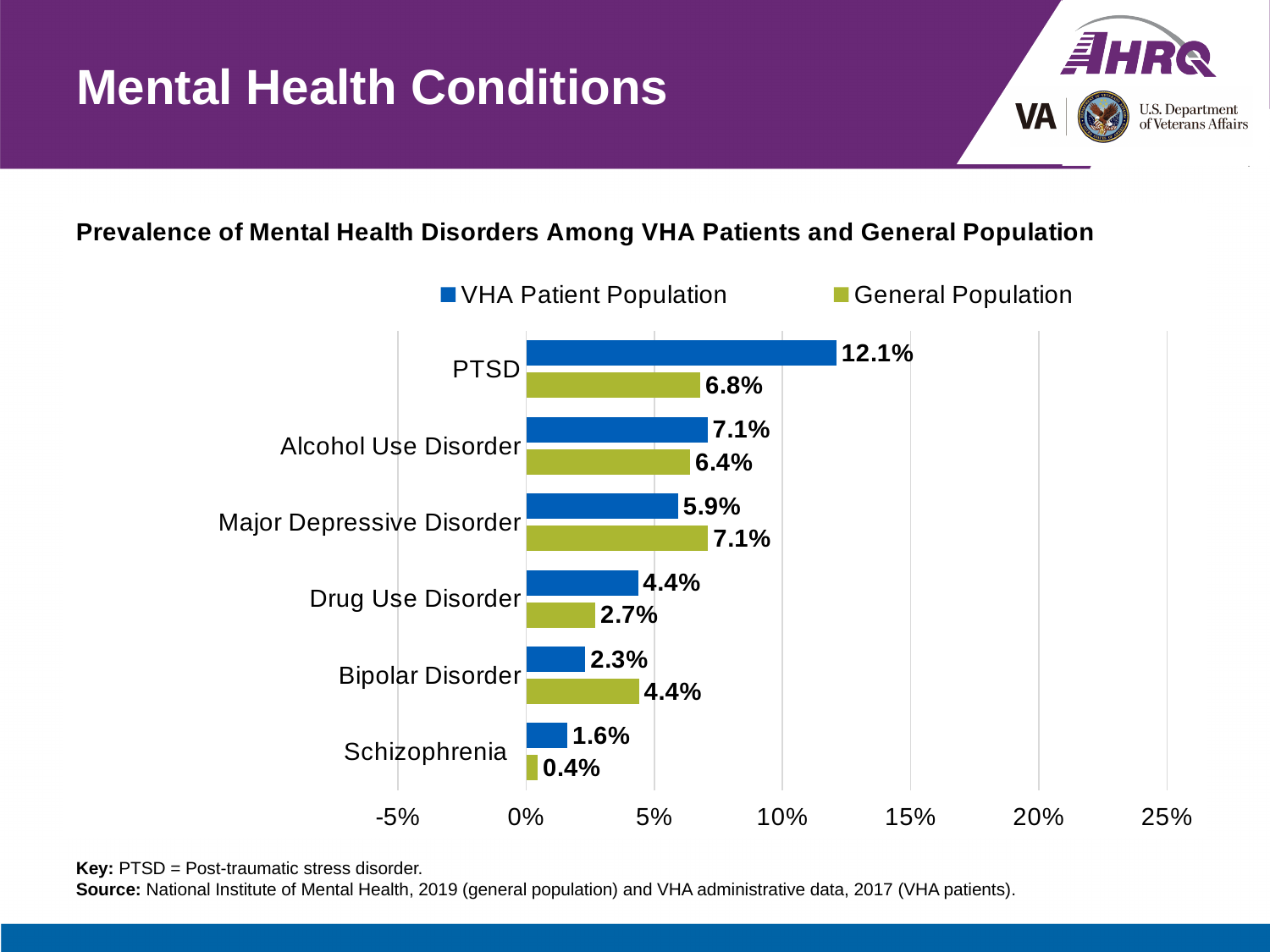
What is the difference between the VHA Patient Population and General Population prevalence for PTSD? 5.3% How many mental health conditions are shown on the chart? 6 Is the VHA Patient Population value for PTSD greater or less than 10%? greater What is the prevalence of PTSD in the VHA Patient Population? 12.1% What colour represents the General Population series? Green What is the title of the chart? Prevalence of Mental Health Disorders Among VHA Patients and General Population What is the prevalence of Bipolar Disorder in the General Population? 4.4% What kind of chart is shown on the slide? Bar chart Which condition has the lowest prevalence in the General Population? Schizophrenia How many series does the legend list? 2 Which condition has the highest prevalence in the VHA Patient Population? PTSD Which is larger for Major Depressive Disorder: the VHA Patient Population value or the General Population value? General Population